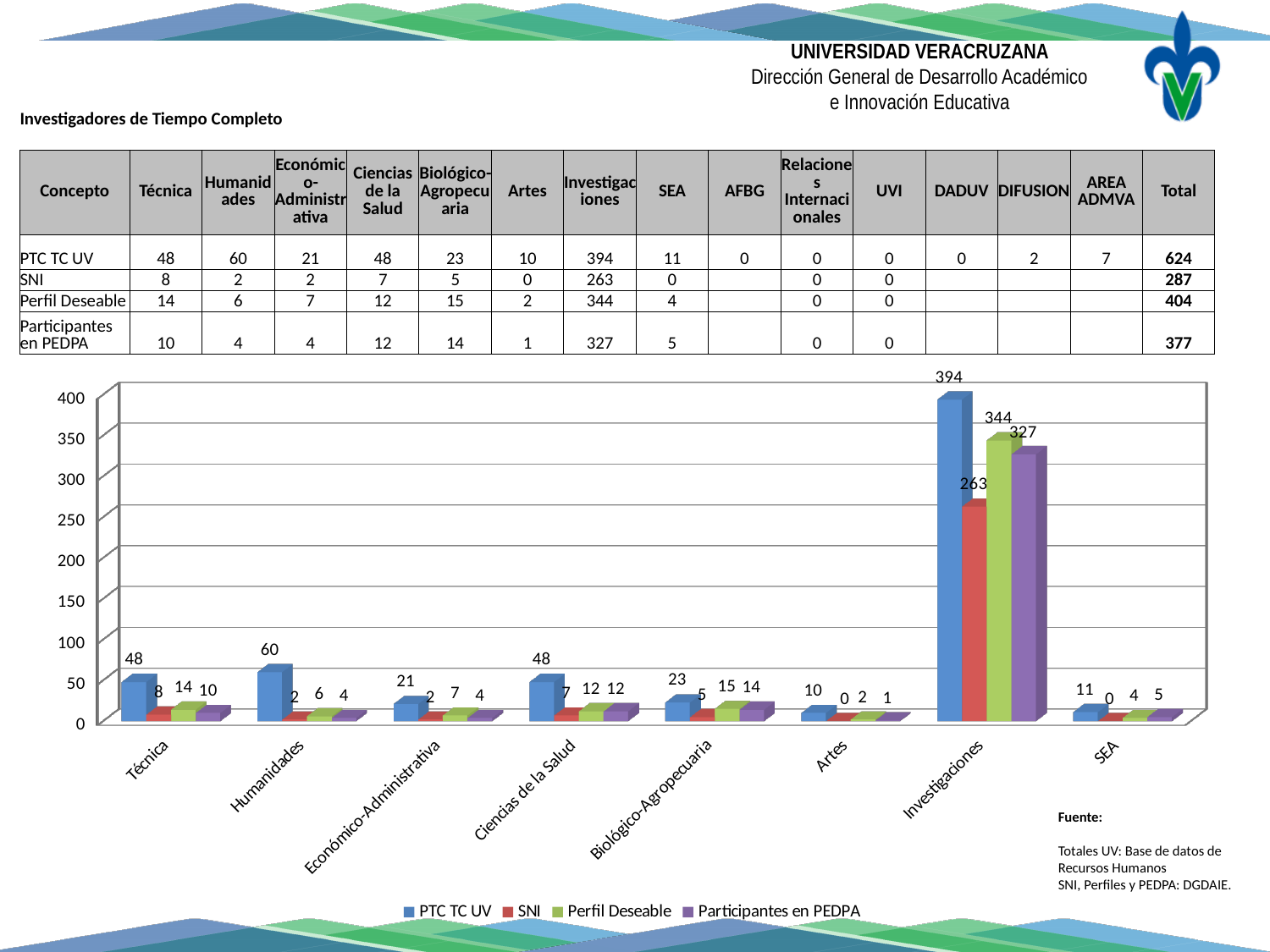
What is the SNI value for Investigaciones in the chart? 263 What is the Perfil Deseable value for Biológico-Agropecuaria in the chart? 15 Which is larger for Humanidades: the PTC TC UV value or the Perfil Deseable value? PTC TC UV Which category has the lowest PTC TC UV value in the chart? Artes How many series does the chart legend list? 4 What is the difference between the Perfil Deseable and Participantes en PEDPA values for Investigaciones? 17 Which series is shown in red in the chart legend? SNI What is the PTC TC UV value for Investigaciones in the chart? 394 How many categories are shown along the x axis of the chart? 8 What type of chart is shown on the slide? bar chart What is the Participantes en PEDPA value for Humanidades in the chart? 4 Which category has the highest PTC TC UV value in the chart? Investigaciones